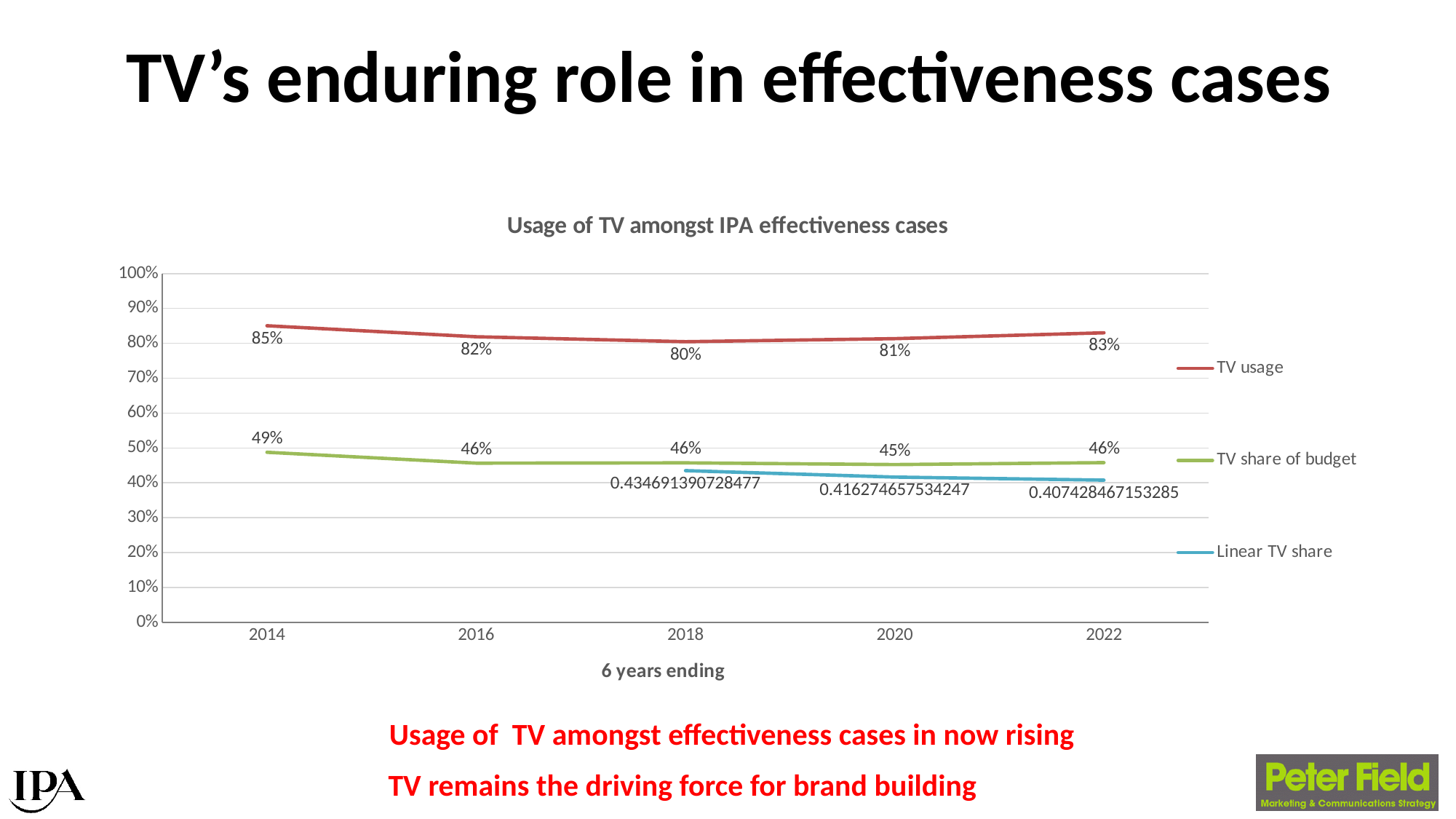
What is the difference between TV usage in 2014 and in 2018? 5% In which year is TV usage lowest? 2018 What kind of chart is shown? line chart What is the TV share of budget value for 2020? 45% What is the title of the chart? Usage of TV amongst IPA effectiveness cases What is the TV usage value for 2014? 85% How many series does the legend list? 3 Which is larger, TV usage in 2022 or TV usage in 2020? TV usage in 2022 Is the Linear TV share value for 2018 greater or less than 50%? less What is the Linear TV share value for 2022? 0.407428467153285 In which year is TV share of budget highest? 2014 How many years are shown on the x axis? 5